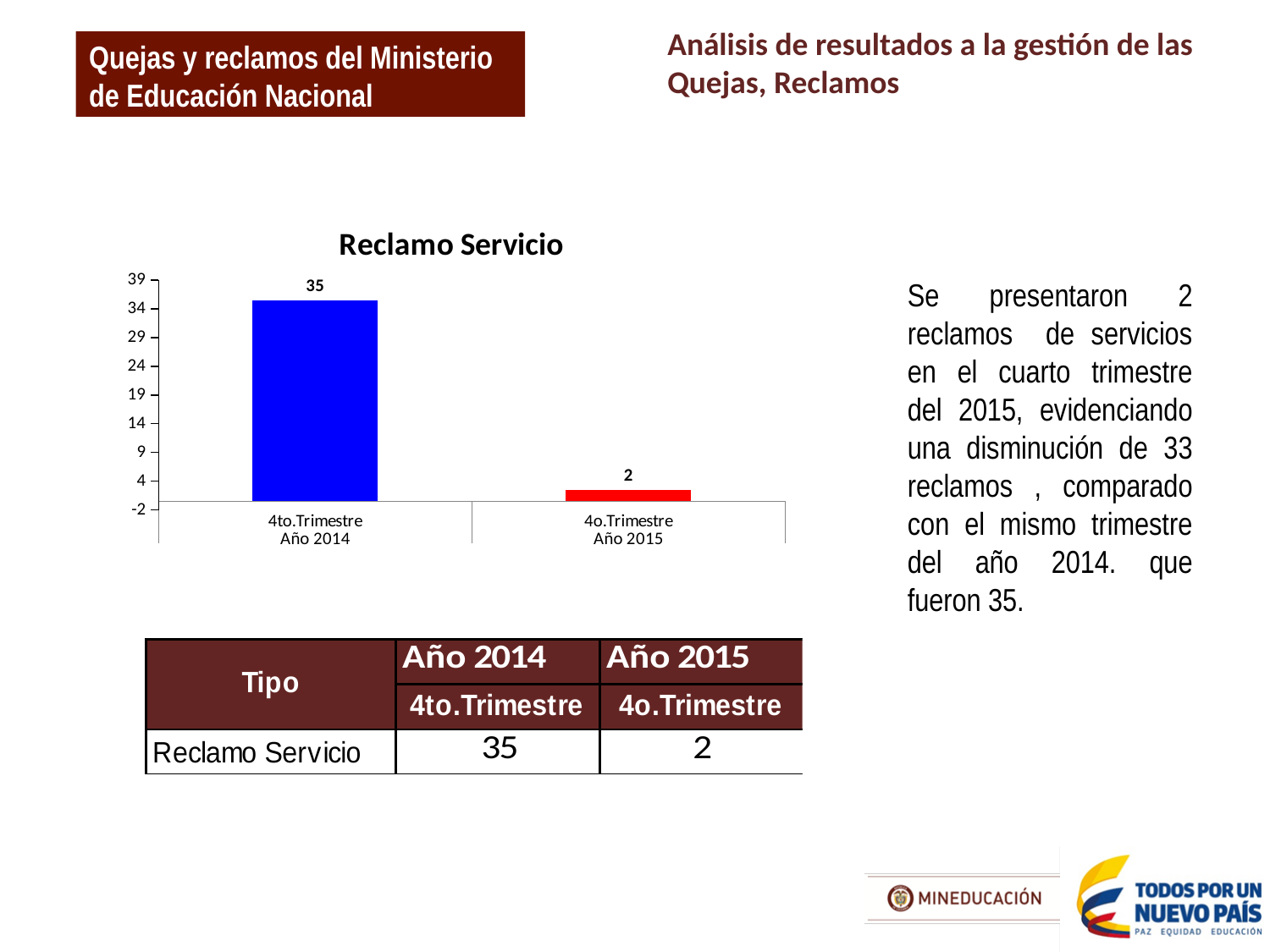
What is the title of the chart on the slide? Reclamo Servicio What is the difference between the 4to.Trimestre Año 2014 value and the 4o.Trimestre Año 2015 value in the Reclamo Servicio chart? 33 Do the values in the Reclamo Servicio chart rise or fall from left to right? fall Which is larger in the Reclamo Servicio chart: the value for 4to.Trimestre Año 2014 or for 4o.Trimestre Año 2015? 4to.Trimestre Año 2014 Is the value for 4to.Trimestre Año 2014 in the Reclamo Servicio chart greater or less than 29? greater How many categories are shown in the Reclamo Servicio chart? 2 What is the value for 4o.Trimestre Año 2015 in the Reclamo Servicio chart? 2 Which category has the lowest value in the Reclamo Servicio chart? 4o.Trimestre Año 2015 What kind of chart is the Reclamo Servicio chart? bar chart What is the value for 4to.Trimestre Año 2014 in the Reclamo Servicio chart? 35 Is the value for 4o.Trimestre Año 2015 in the Reclamo Servicio chart greater or less than 9? less Which category has the highest value in the Reclamo Servicio chart? 4to.Trimestre Año 2014